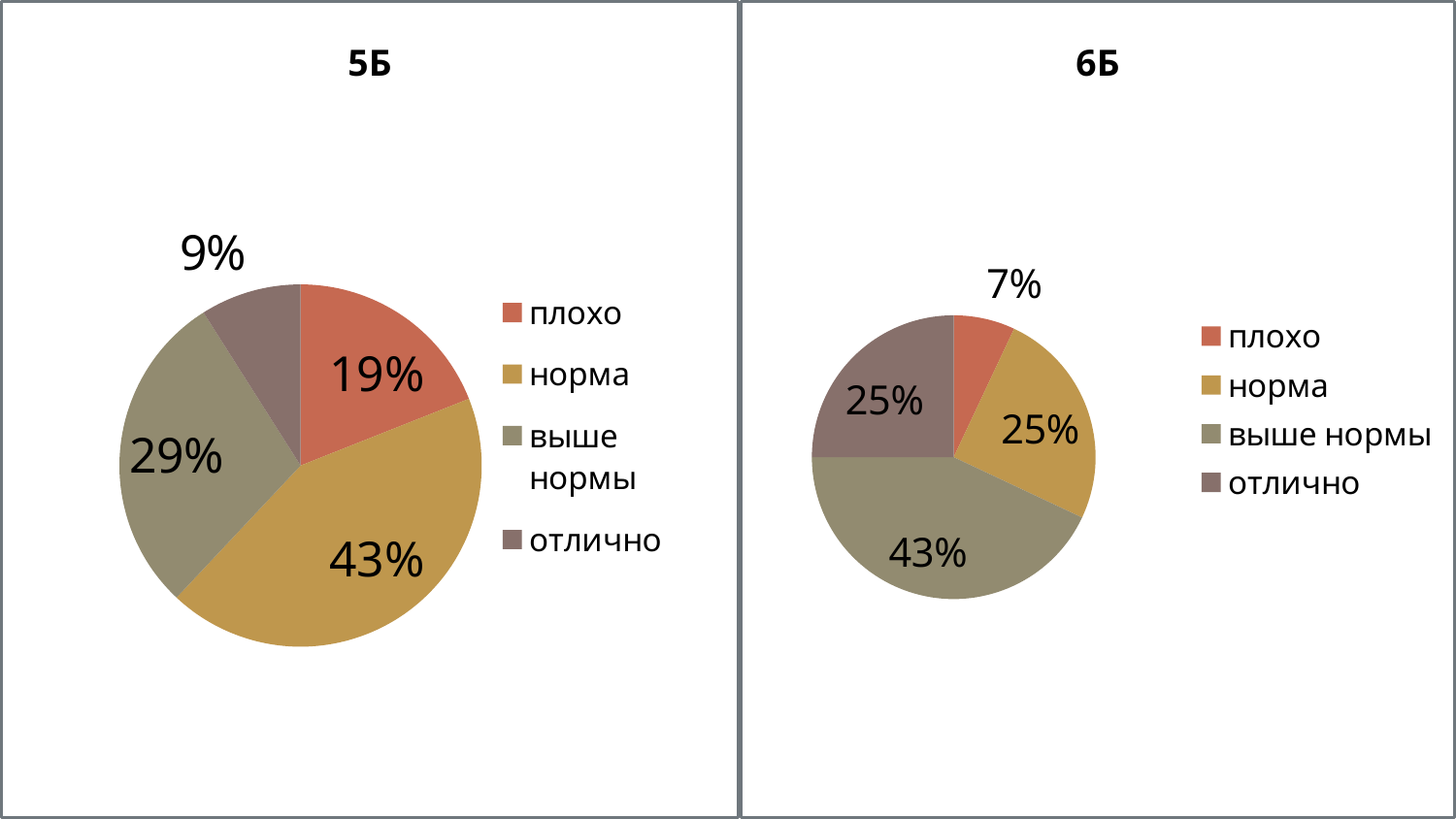
In the chart titled 6Б, which category has the smallest slice? плохо In the chart titled 5Б, what share does the slice for норма have? 43% In the chart titled 5Б, what share does the slice for отлично have? 9% In the chart titled 5Б, what is the difference in percentage points between выше нормы and плохо? 10 In the chart titled 5Б, which category has the largest slice? норма How many categories does the legend of the chart titled 5Б list? 4 In the chart titled 6Б, which is larger, the slice for норма or the slice for плохо? норма What kind of chart is the chart titled 6Б? pie chart In the chart titled 5Б, what share does the slice for плохо have? 19% In the chart titled 6Б, what share does the slice for выше нормы have? 43% In the chart titled 5Б, which category has the smallest slice? отлично In the chart titled 6Б, what share does the slice for плохо have? 7%